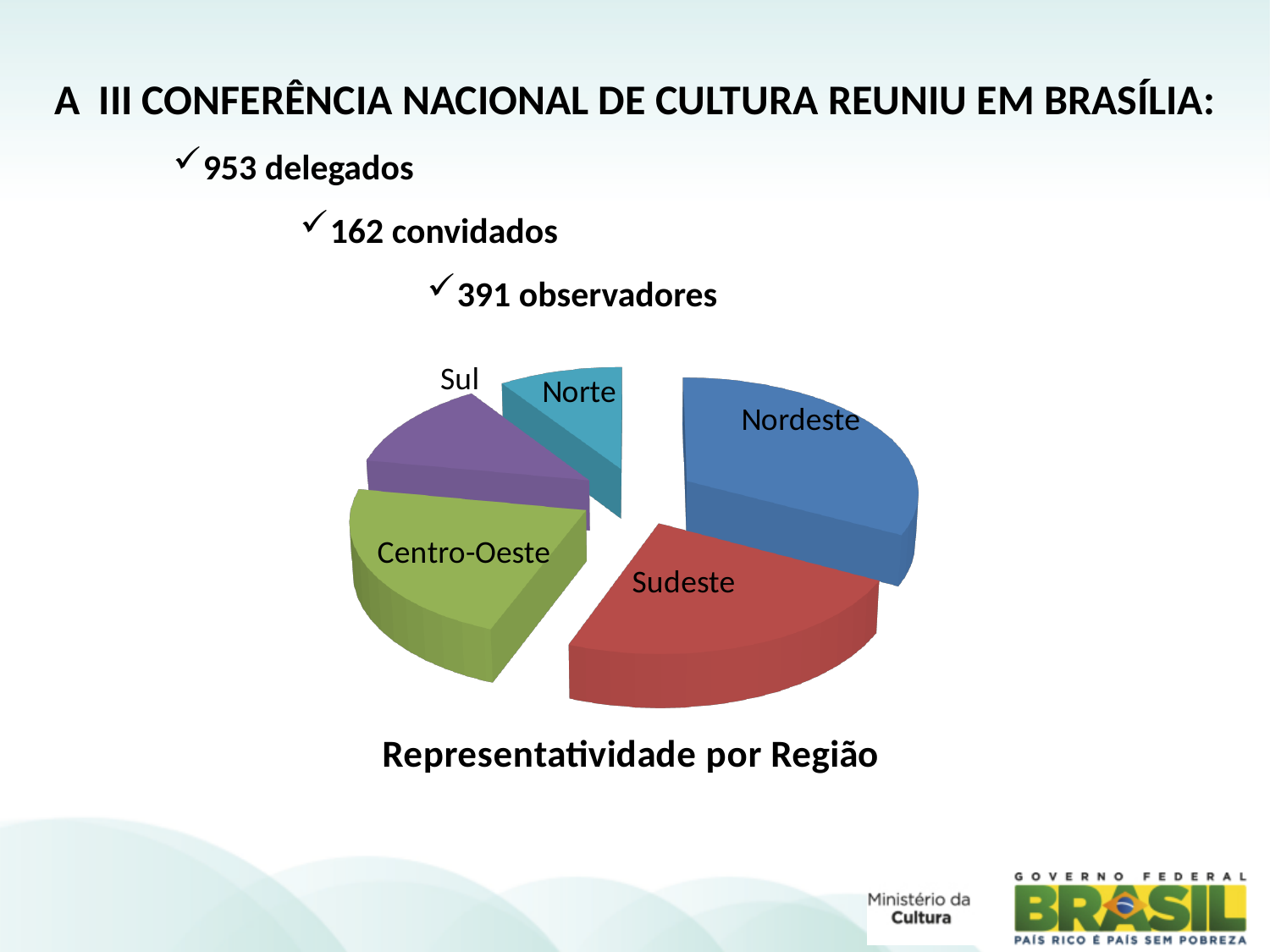
What colour is the Nordeste slice of the pie chart? blue Which slice is larger, Sul or Norte? Sul How many regions (slices) does the pie chart show? 5 Which region has the largest slice in the pie chart? Nordeste What is the title of the pie chart? Representatividade por Região Which slice is larger, Centro-Oeste or Norte? Centro-Oeste What kind of chart is shown on the slide? pie chart Which region has the smallest slice in the pie chart? Norte Which slice is larger, Sudeste or Sul? Sudeste